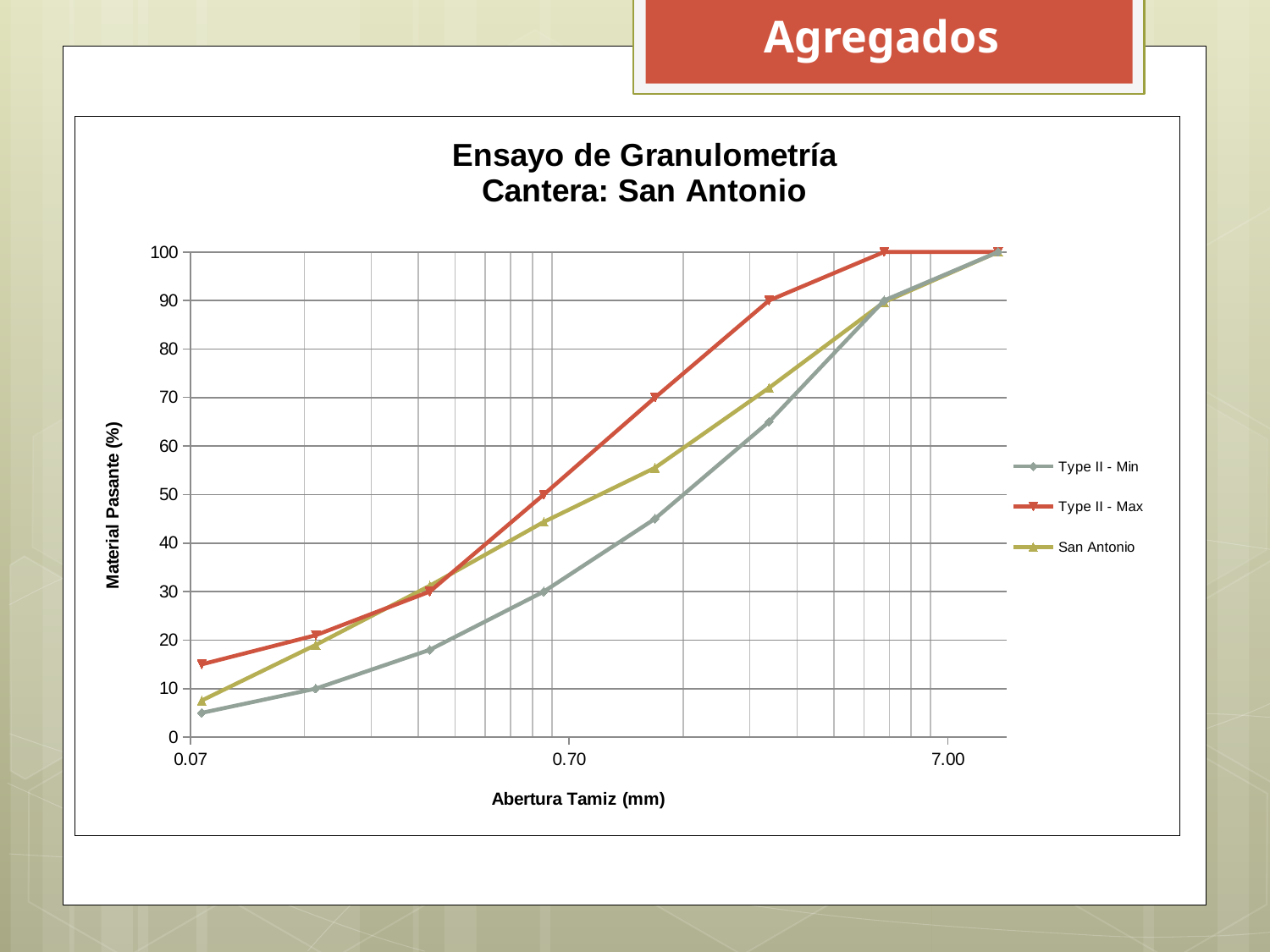
At 0.70 mm, which is larger: the value for San Antonio or the value for Type II - Min? San Antonio Is the value for San Antonio at 0.70 mm greater or less than 50? less Which series has the highest value at 0.70 mm? Type II - Max Is the value for Type II - Min at 0.07 mm greater or less than 10? less Is the value for Type II - Max at 0.07 mm greater or less than 10? greater How many series does the legend list? 3 Do the values of the San Antonio series rise or fall as the sieve opening (Abertura Tamiz) increases? rise Which series is plotted in red? Type II - Max What kind of chart is shown on the slide? line chart What is the label of the y axis? Material Pasante (%) At 0.07 mm, which is larger: the value for Type II - Max or the value for Type II - Min? Type II - Max